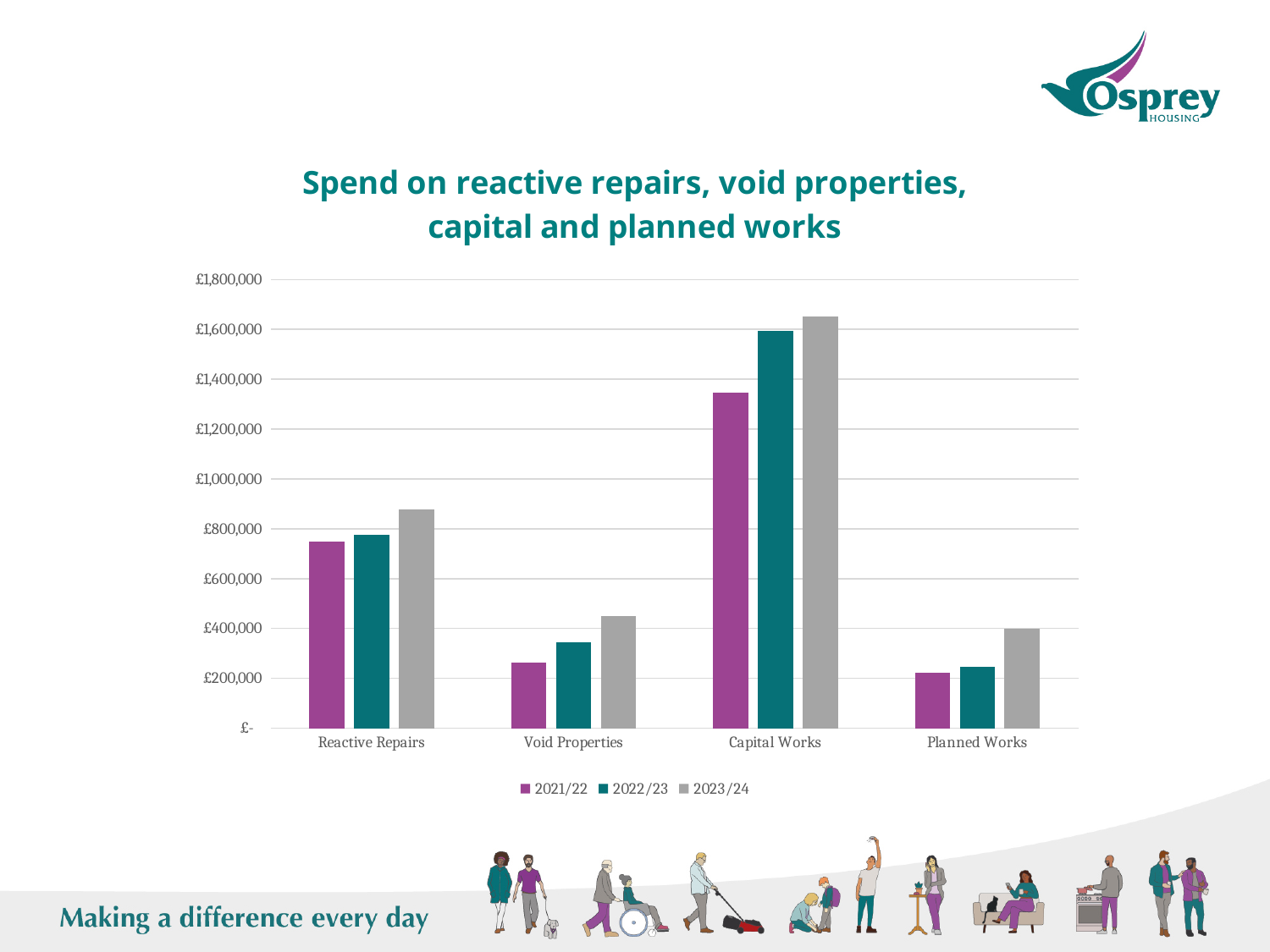
Which category has the lowest spend for 2021/22? Planned Works How many categories are shown on the x axis of the chart? 4 Is the 2023/24 value for Capital Works greater or less than £1,400,000? greater Which series is shown in purple in the chart's legend? 2021/22 Which category has the highest spend for 2023/24? Capital Works Within each category, does the spend rise or fall from 2021/22 to 2023/24? Rise Is the 2021/22 value for Void Properties greater or less than £400,000? less What kind of chart is shown on the slide? Bar chart How many series does the chart's legend list? 3 Is the 2023/24 value for Reactive Repairs greater or less than £800,000? greater Which is larger: the 2023/24 spend on Reactive Repairs or the 2023/24 spend on Void Properties? Reactive Repairs